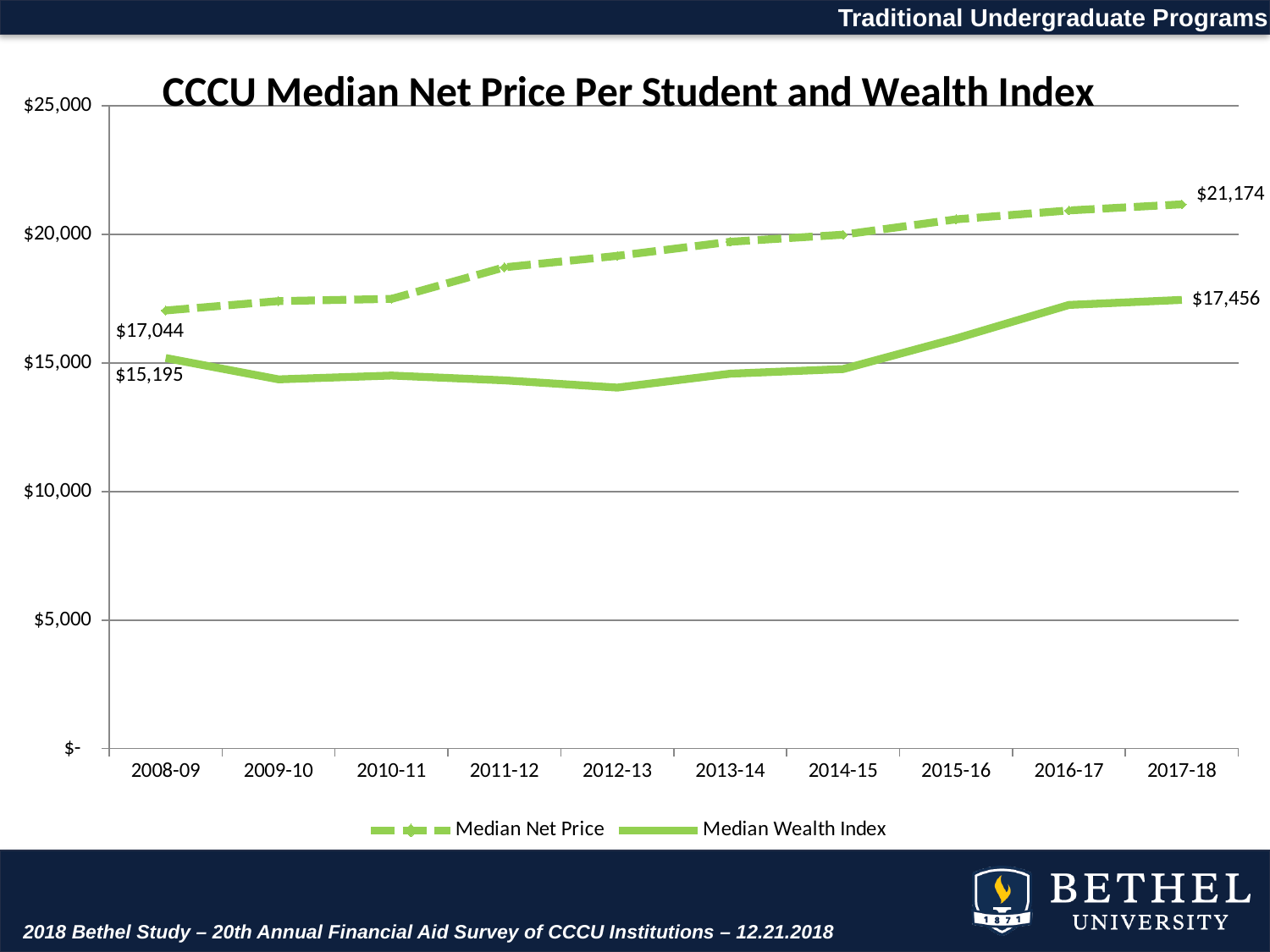
What kind of chart is shown on the slide? Line chart What is the Median Wealth Index for 2008-09? $15,195 What is the difference between the Median Net Price and the Median Wealth Index in 2017-18? $3,718 Which is larger in 2017-18, the Median Net Price or the Median Wealth Index? Median Net Price What is the Median Wealth Index for 2017-18? $17,456 Is the Median Wealth Index for 2012-13 greater or less than $15,000? less What is the Median Net Price for 2017-18? $21,174 How many series does the legend list? 2 Is the Median Net Price for 2010-11 greater or less than $20,000? less By how much did the Median Net Price increase from 2008-09 to 2017-18? $4,130 How many academic years are shown on the x axis? 10 What is the Median Net Price for 2008-09? $17,044